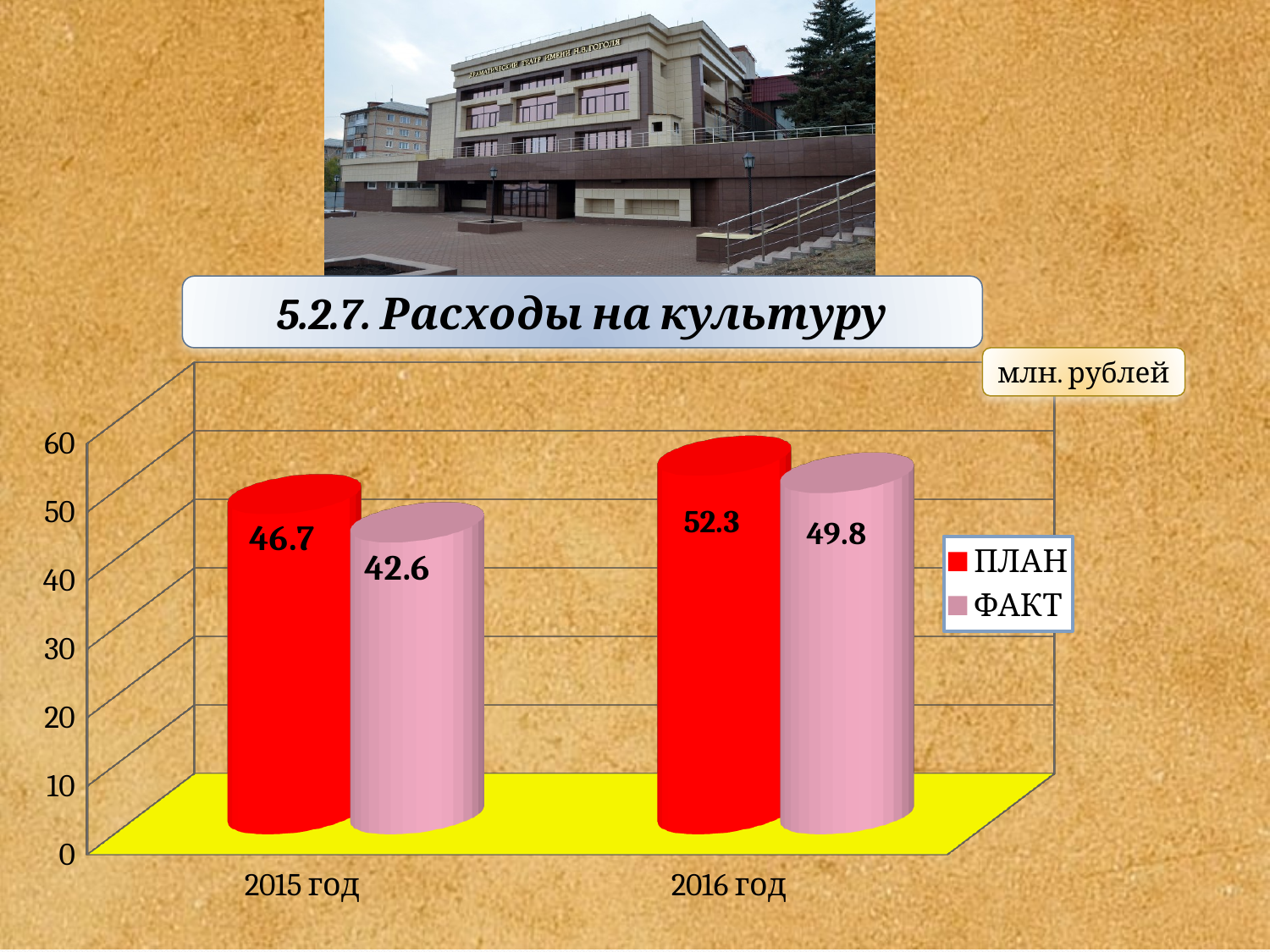
What kind of chart is shown on the slide? bar chart How many series does the legend list? 2 What is the ПЛАН value for 2015 год? 46.7 What is the ФАКТ value for 2015 год? 42.6 Which is larger: the ПЛАН value for 2015 год or the ФАКТ value for 2016 год? ФАКТ value for 2016 год What is the difference between the ФАКТ values for 2016 год and 2015 год? 7.2 Which year has the lowest ФАКТ value? 2015 год What is the ФАКТ value for 2016 год? 49.8 Do the ПЛАН values rise or fall from 2015 год to 2016 год? rise Which year has the highest ПЛАН value? 2016 год How many year categories are shown on the x axis? 2 What is the difference between the ПЛАН and ФАКТ values for 2016 год? 2.5